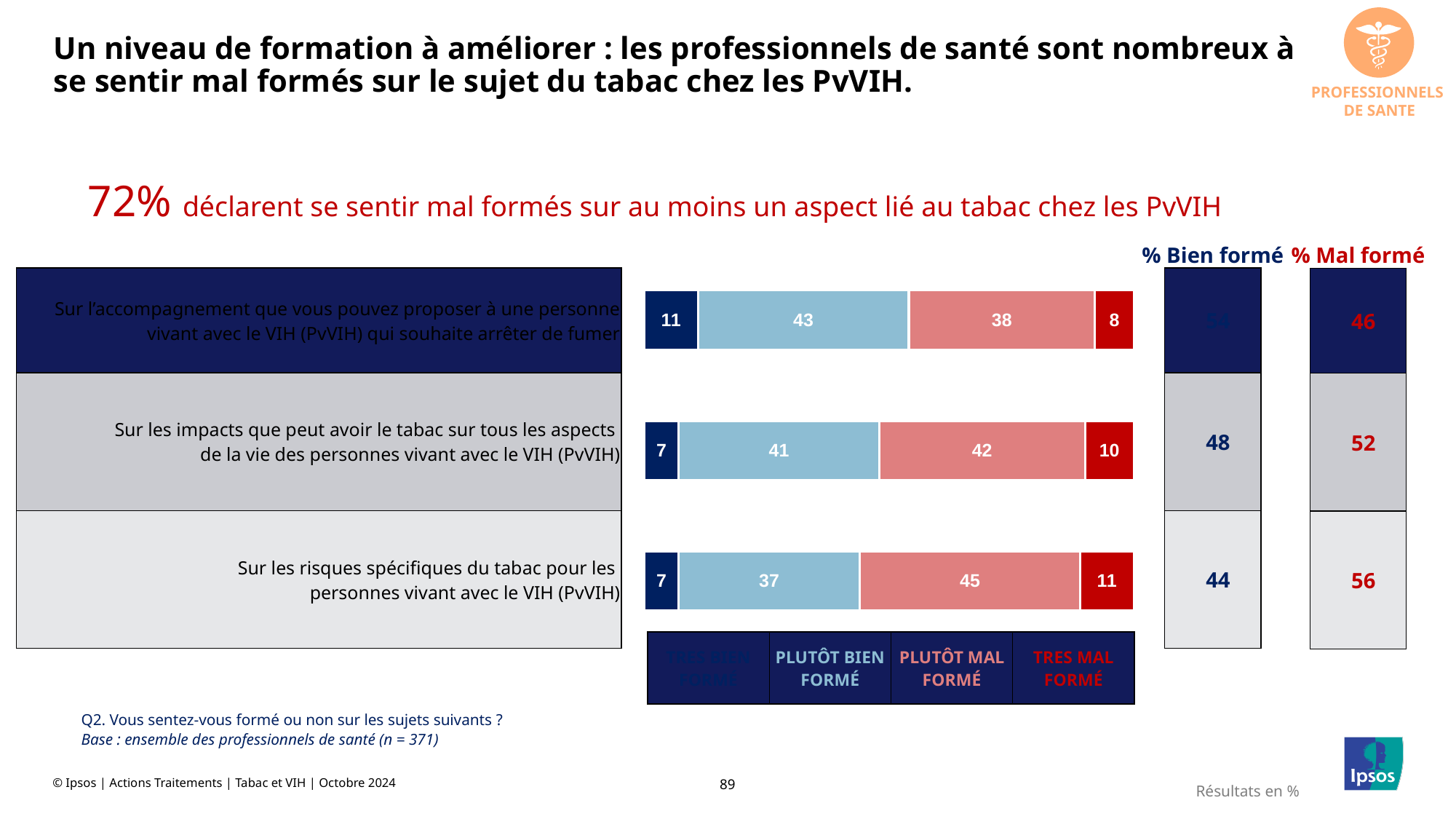
What is the 'Plutôt bien formé' value for 'Sur l'accompagnement que vous pouvez proposer à une personne vivant avec le VIH (PvVIH) qui souhaite arrêter de fumer'? 43 Which topic has the lowest '% Mal formé' value? Sur l'accompagnement que vous pouvez proposer à une personne vivant avec le VIH (PvVIH) qui souhaite arrêter de fumer What is the '% Mal formé' value for 'Sur les risques spécifiques du tabac pour les personnes vivant avec le VIH (PvVIH)'? 56 What is the difference between the 'Plutôt bien formé' values for 'Sur l'accompagnement...' (43) and 'Sur les risques spécifiques...' (37)? 6 Which topic has the highest 'Plutôt mal formé' value? Sur les risques spécifiques du tabac pour les personnes vivant avec le VIH (PvVIH) How many series does the legend list? 4 What is the total of the 'Plutôt mal formé' and 'Très mal formé' segments for 'Sur les impacts que peut avoir le tabac sur tous les aspects de la vie des personnes vivant avec le VIH (PvVIH)'? 52 What is the 'Très mal formé' value for 'Sur les risques spécifiques du tabac pour les personnes vivant avec le VIH (PvVIH)'? 11 What is the 'Plutôt mal formé' value for 'Sur les impacts que peut avoir le tabac sur tous les aspects de la vie des personnes vivant avec le VIH (PvVIH)'? 42 What kind of chart is shown on the slide? stacked bar chart How many topics (categories) are plotted in the chart? 3 Is the 'Plutôt mal formé' value larger for 'Sur les impacts que peut avoir le tabac...' or for 'Sur les risques spécifiques du tabac...'? Sur les risques spécifiques du tabac pour les personnes vivant avec le VIH (PvVIH)